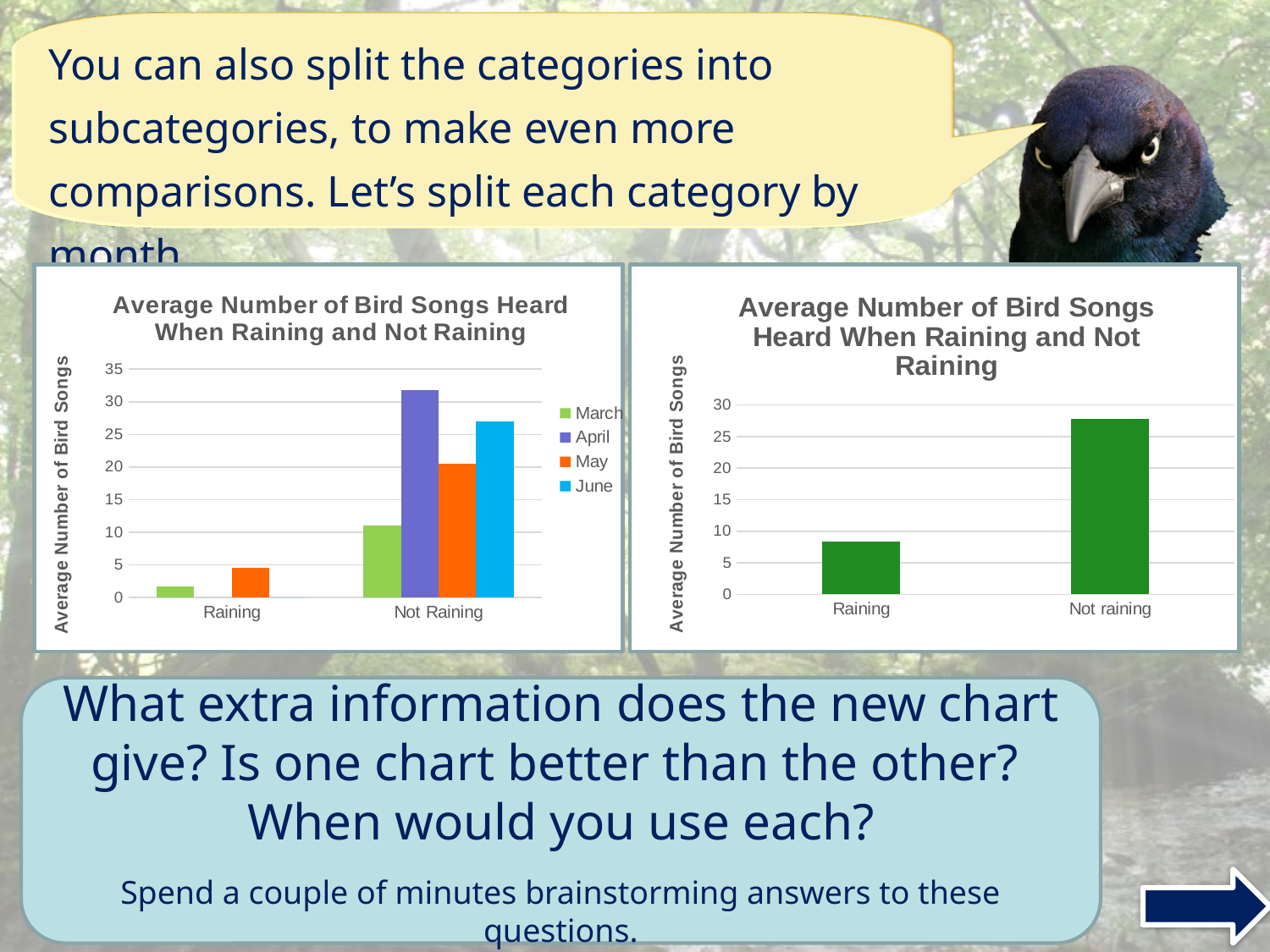
What type of chart is the right chart? Bar chart On the right chart, how many categories are shown on the x axis? 2 On the left chart, is the May value for Not Raining greater or less than 15? greater On the right chart, which category has the higher value? Not raining On the left chart, which month has the highest bar in the Not Raining category? April On the right chart, is the value for Not raining greater or less than 25? greater On the left chart, is the April value for Not Raining greater or less than 30? greater On the left chart, which is larger for Not Raining: the June bar or the May bar? June On the left chart, how many series does the legend list? 4 On the left chart, which is larger for Raining: the March bar or the May bar? May